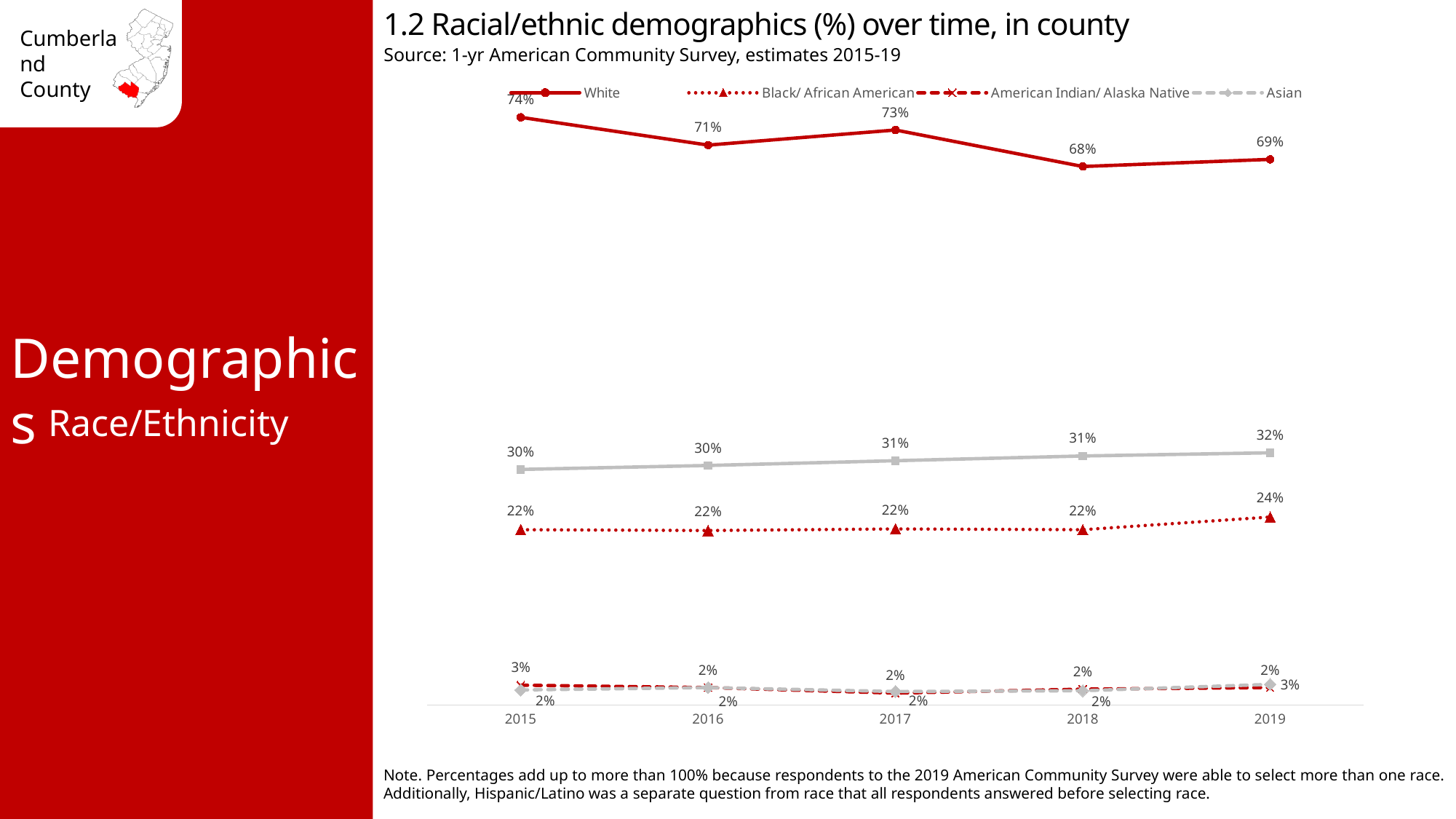
How many years are shown on the x axis? 5 Does the Black/ African American value rise or fall from 2018 to 2019? Rise What is the value for White in 2018? 68% What kind of chart is shown on the slide? Line chart How many series does the legend list? 4 In which year is the White value lowest? 2018 What is the difference between the White value in 2015 and in 2019? 5 percentage points In which year is the White value highest? 2015 What is the value for White in 2015? 74% What is the value for Black/ African American in 2016? 22% Which year has the larger White value, 2016 or 2017? 2017 What is the value for Black/ African American in 2019? 24%